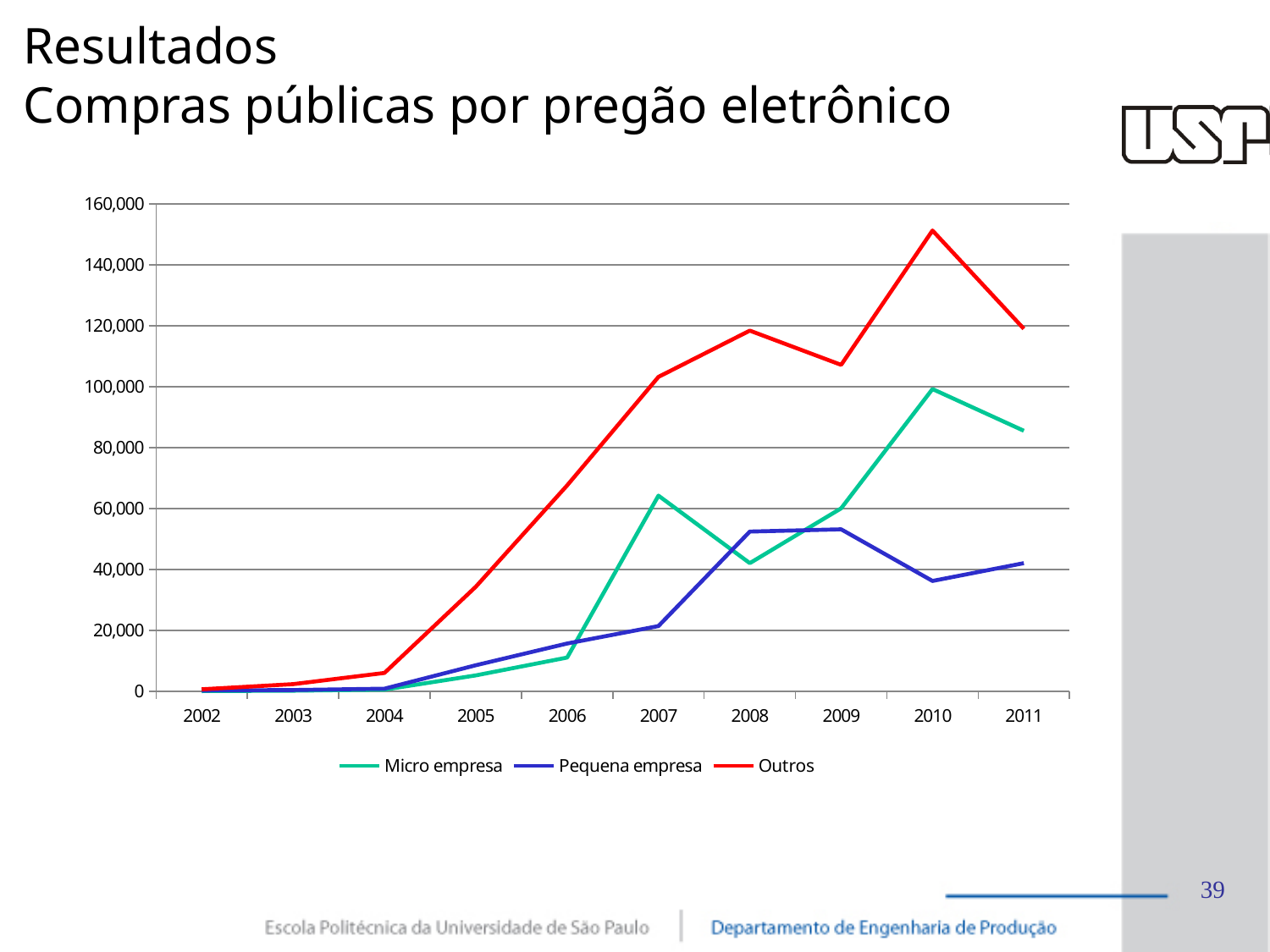
Which series has the lowest value in 2011? Pequena empresa In 2010, which is larger: Micro empresa or Pequena empresa? Micro empresa In which year does the Outros series reach its highest value? 2010 Is the value for Pequena empresa in 2010 greater or less than 40,000? less Does the Outros series rise or fall from 2010 to 2011? fall How many years are shown on the x axis? 10 Is the value for Micro empresa in 2011 greater or less than 80,000? greater Is the value for Outros in 2010 greater or less than 140,000? greater In which year does the Micro empresa series reach its highest value? 2010 How many series does the legend list? 3 In 2008, which is larger: Micro empresa or Pequena empresa? Pequena empresa What type of chart is shown on the slide? line chart